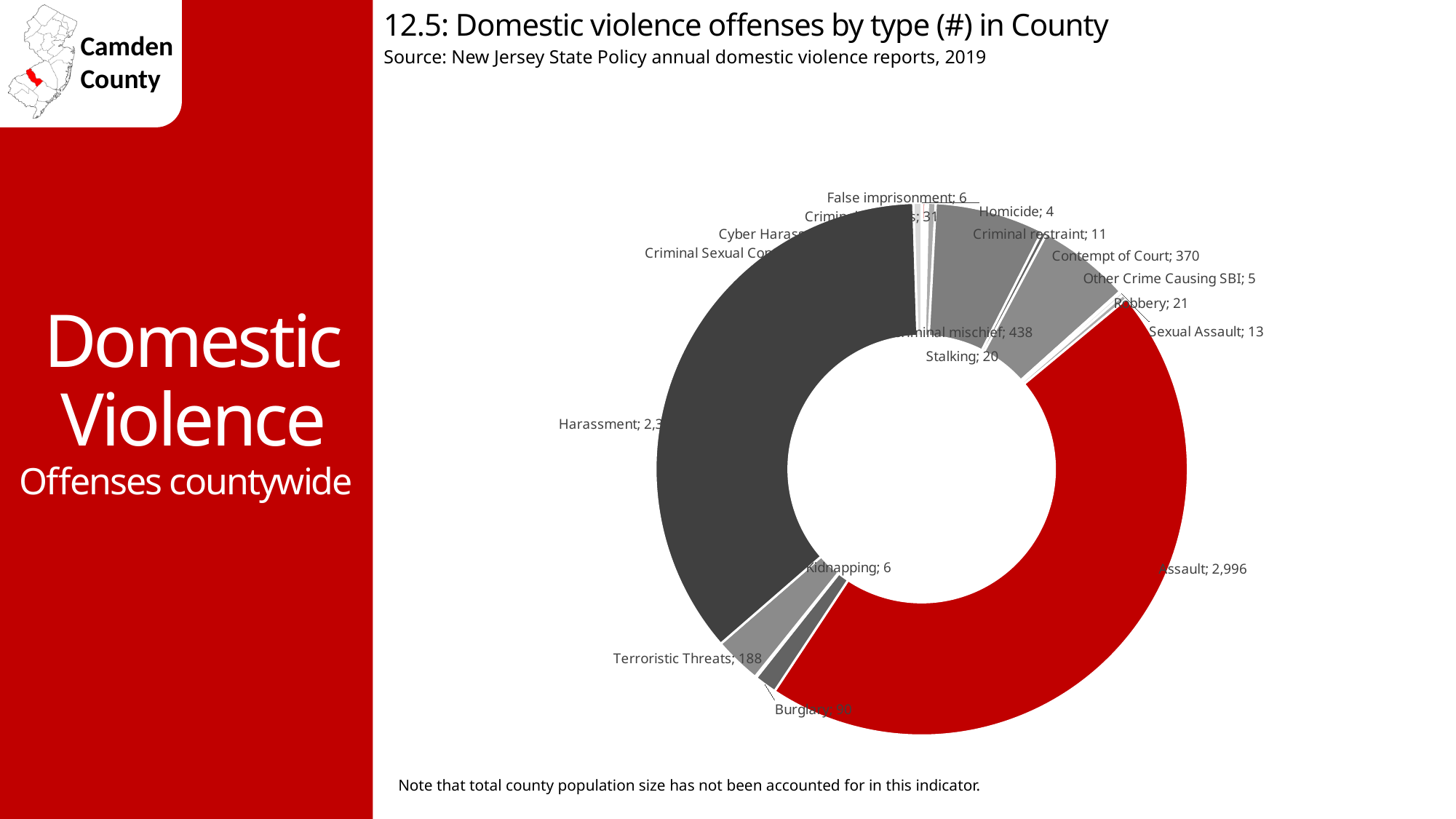
What is the value for Robbery? 21 What is the value for Contempt of Court? 370 Which is larger, the value for Contempt of Court or the value for Terroristic Threats? Contempt of Court Which offense type has the highest value? Assault What is the value for Sexual Assault? 13 What is the difference between the values for Assault and Contempt of Court? 2,626 What is the value for Homicide? 4 What is the value for Assault? 2,996 What is the value for Burglary? 90 What kind of chart is shown on the slide? Pie (doughnut) chart What is the value for Terroristic Threats? 188